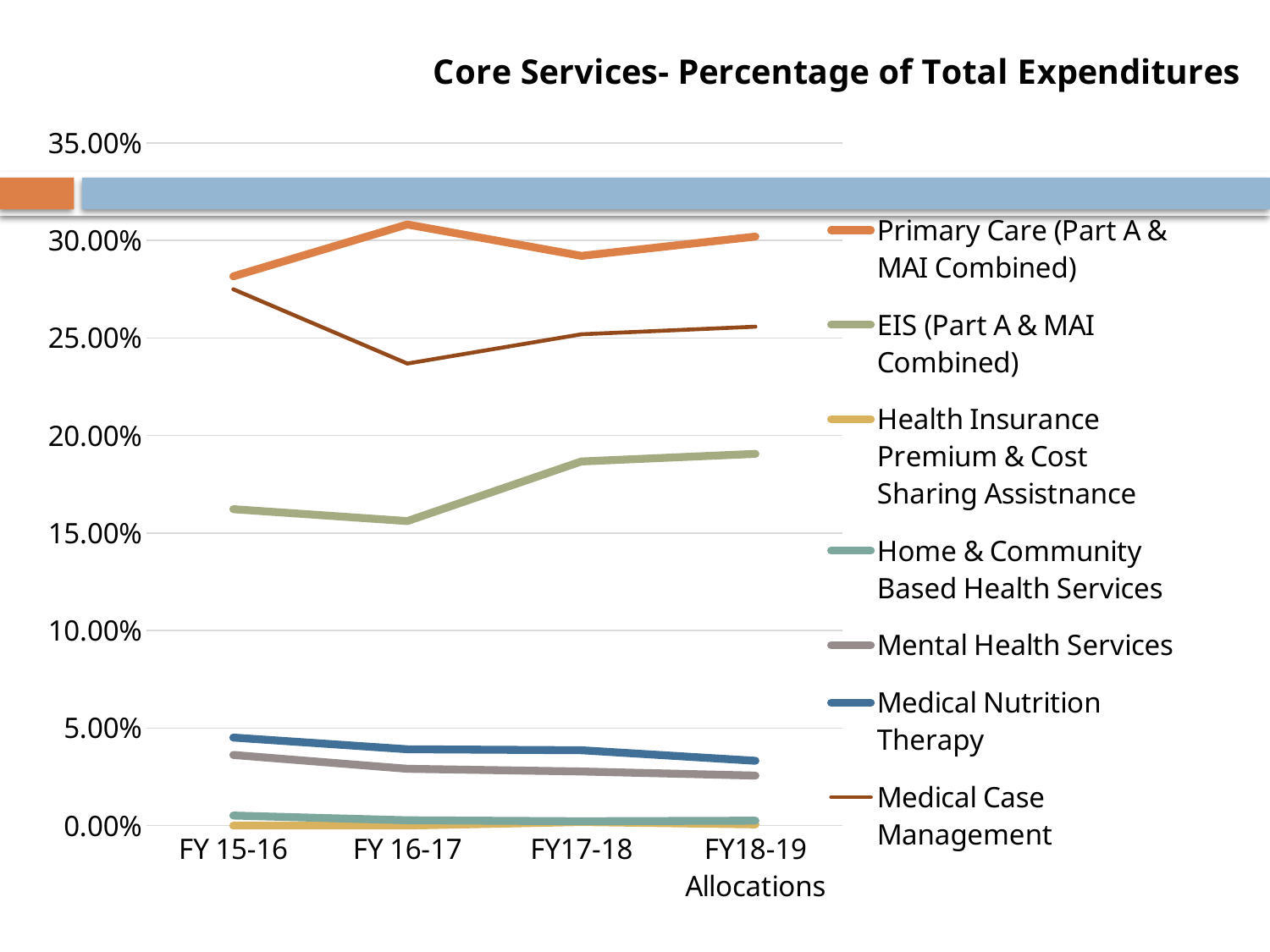
What kind of chart is shown on the slide? line chart Is the value for Medical Case Management at FY 16-17 greater or less than 25.00%? less Which series has the highest value at FY18-19 Allocations? Primary Care (Part A & MAI Combined) How many fiscal year categories are shown on the x axis? 4 Is the value for Primary Care (Part A & MAI Combined) at FY 16-17 greater or less than 30.00%? greater What is the title of the chart? Core Services- Percentage of Total Expenditures Is the value for EIS (Part A & MAI Combined) at FY18-19 Allocations greater or less than 20.00%? less How many series does the legend list? 7 Does the EIS (Part A & MAI Combined) line rise or fall overall from FY 15-16 to FY18-19 Allocations? rise Does the Medical Nutrition Therapy line rise or fall from FY 15-16 to FY18-19 Allocations? fall Which is larger at FY17-18: EIS (Part A & MAI Combined) or Medical Case Management? Medical Case Management